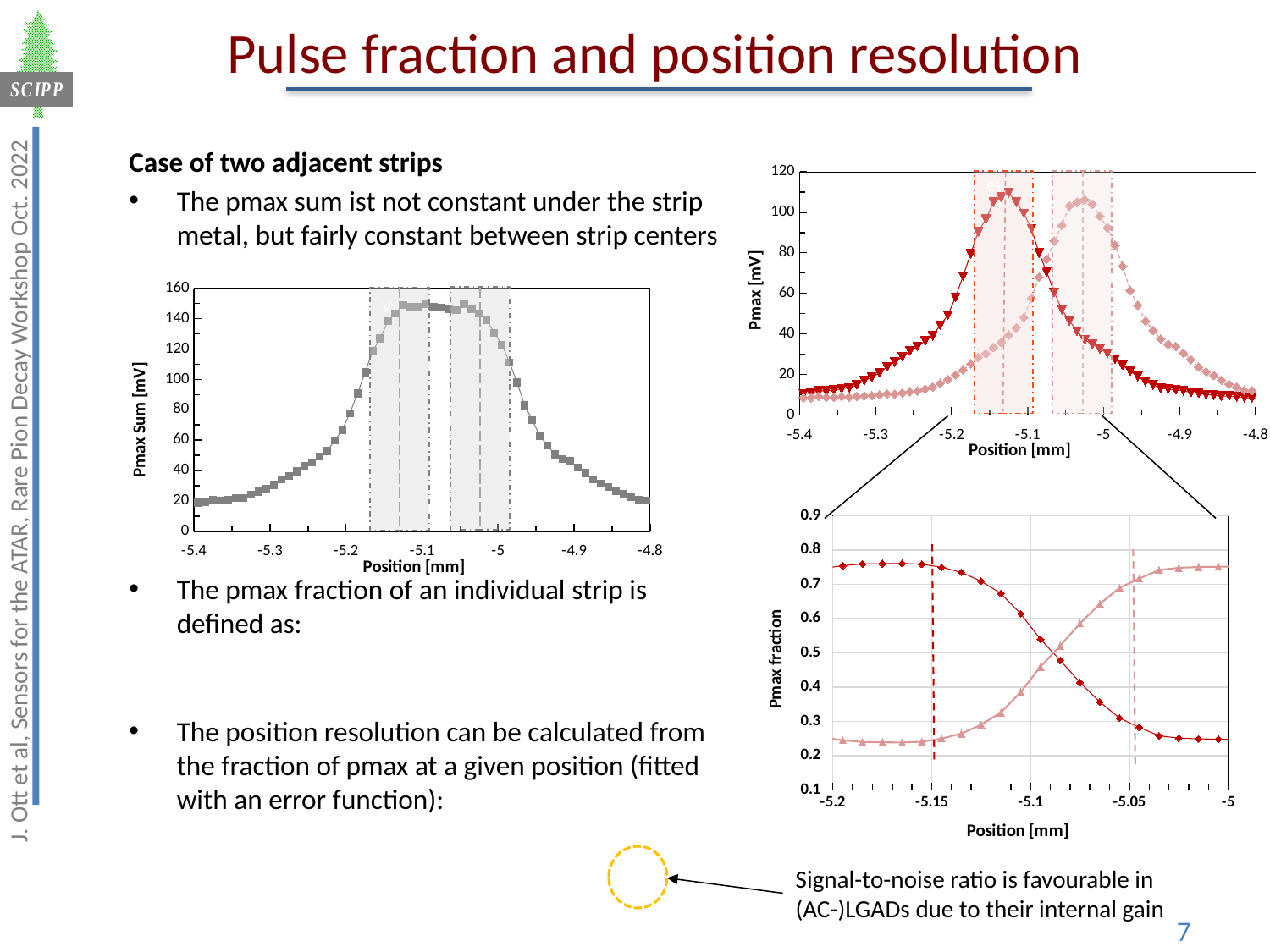
In the bottom-right chart (Pmax fraction), is the light pink series value at position -5.2 mm greater or less than 0.3? less In the left chart (Pmax Sum [mV]), what is the highest value shown on the y axis? 160 In the bottom-right chart (Pmax fraction), is the dark red series value at position -5.2 mm greater or less than 0.7? greater In the top-right chart (Pmax [mV]), is the dark red series value at position -5.4 mm greater or less than 20? less In the top-right chart (Pmax [mV]), what is the label of the x axis? Position [mm] In the bottom-right chart (Pmax fraction), does the light pink series rise or fall as position increases from -5.2 to -5? rise What kind of chart is the left chart with the y axis labelled Pmax Sum [mV]? line chart In the bottom-right chart (Pmax fraction), does the dark red series rise or fall as position increases from -5.2 to -5? fall In the bottom-right chart (Pmax fraction), at position -5 mm, which series has the larger value, the dark red or the light pink? light pink